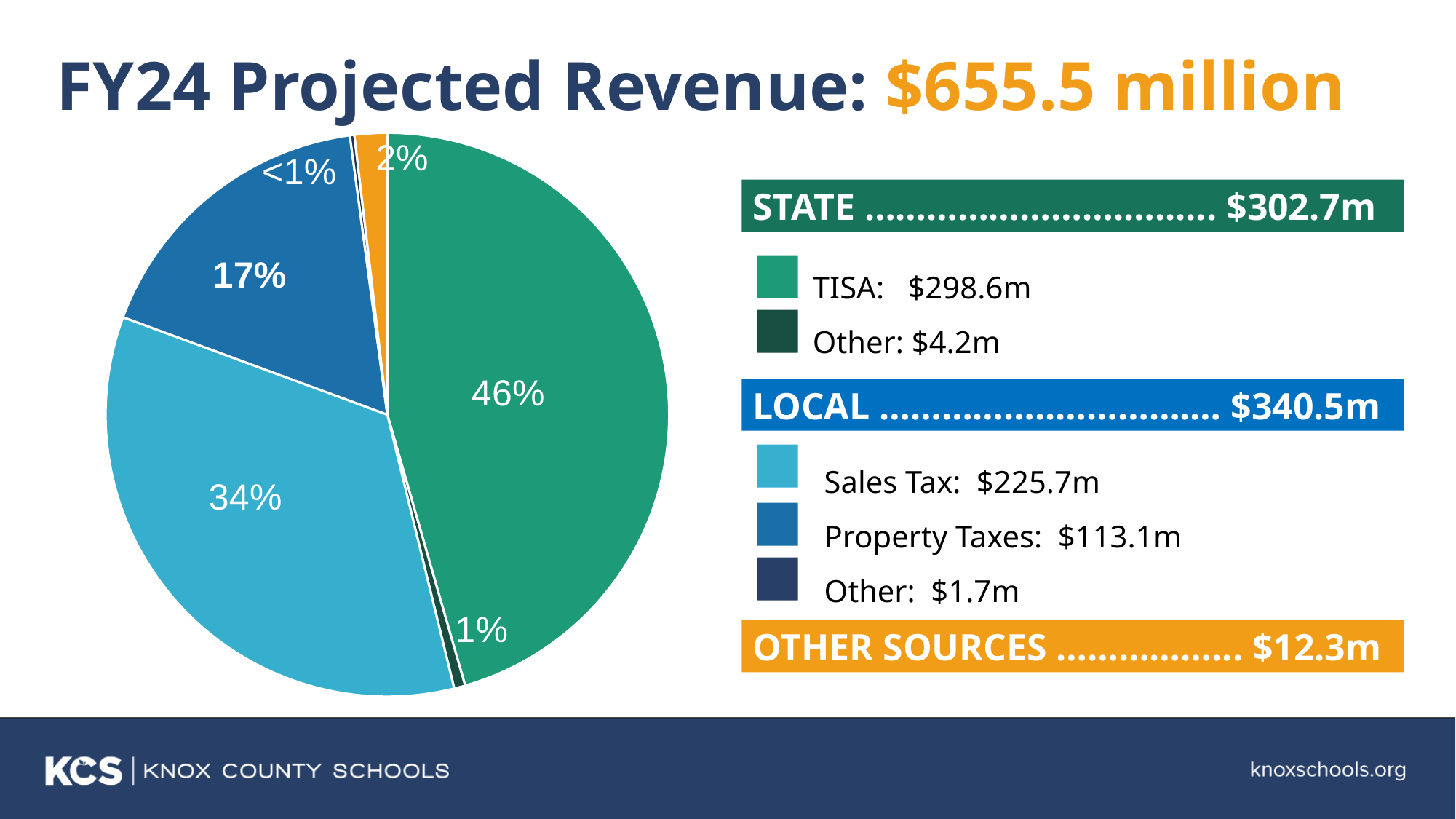
How many slices does the pie chart have? 6 Which is larger, the total State revenue or the total Local revenue? Local What share of the pie does Sales Tax represent? 34% Which slice of the pie is the largest? TISA What kind of chart is shown on the slide? pie chart How much larger is the Sales Tax revenue than the Property Taxes revenue? $112.6m What share of the pie does TISA represent? 46% What share of the pie does Property Taxes represent? 17% What is the projected revenue from Other Sources? $12.3m Which slice of the pie is the smallest? Local Other What is the projected revenue from TISA? $298.6m What is the projected revenue from Sales Tax? $225.7m